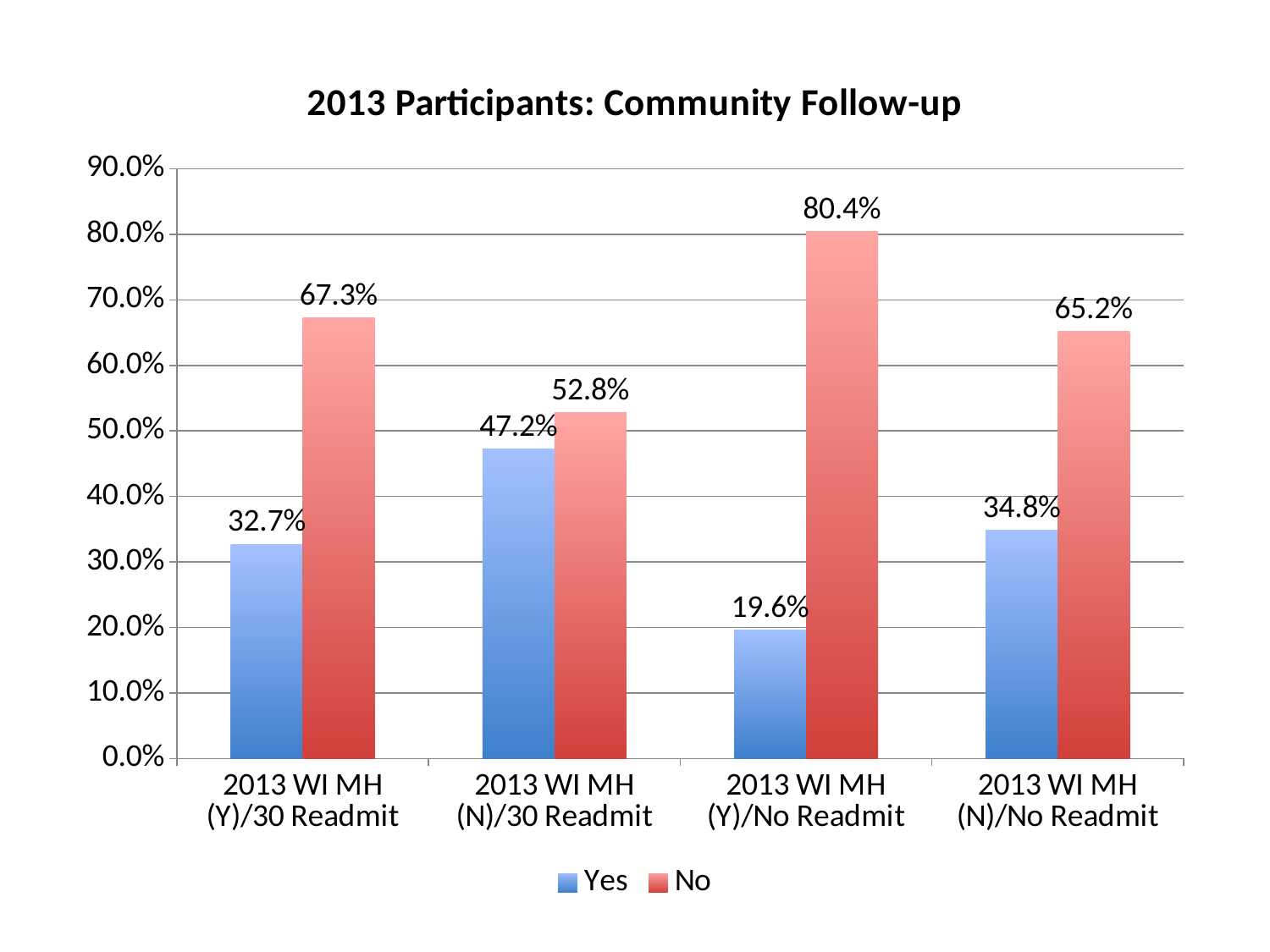
What kind of chart is shown on the slide? Bar chart What is the 'Yes' value for 2013 WI MH (N)/No Readmit? 34.8% How many categories are shown on the x axis? 4 Which category has the highest 'No' value? 2013 WI MH (Y)/No Readmit Which is larger for 2013 WI MH (Y)/30 Readmit, the 'Yes' value or the 'No' value? No Which category has the lowest 'Yes' value? 2013 WI MH (Y)/No Readmit What is the 'No' value for 2013 WI MH (Y)/No Readmit? 80.4% What is the difference between the 'No' and 'Yes' values for 2013 WI MH (N)/30 Readmit? 5.6% How many series does the legend list? 2 What is the 'Yes' value for 2013 WI MH (Y)/30 Readmit? 32.7% What is the title of the chart? 2013 Participants: Community Follow-up Is the 'No' value for 2013 WI MH (N)/No Readmit greater or less than 60.0%? greater